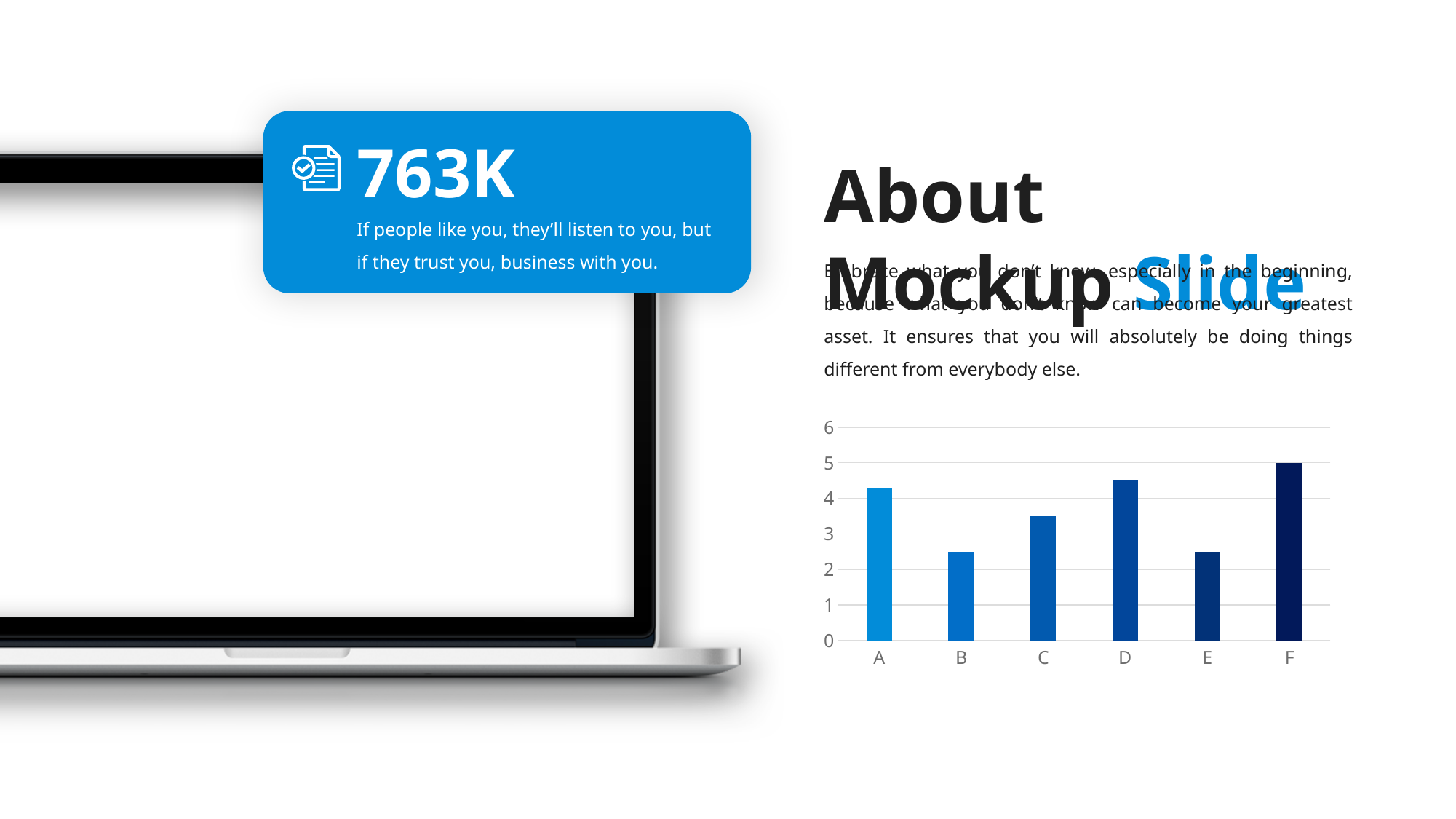
Is the value for B greater or less than 3? less Is the value for E greater or less than 3? less Which is larger, the value for A or the value for B? A What kind of chart is shown on the slide? bar chart What is the value for category F? 5 Which is larger, the value for D or the value for C? D Is the value for A greater or less than 4? greater What is the highest value shown on the vertical axis of the chart? 6 Which category has the highest bar? F How many categories are plotted on the bar chart? 6